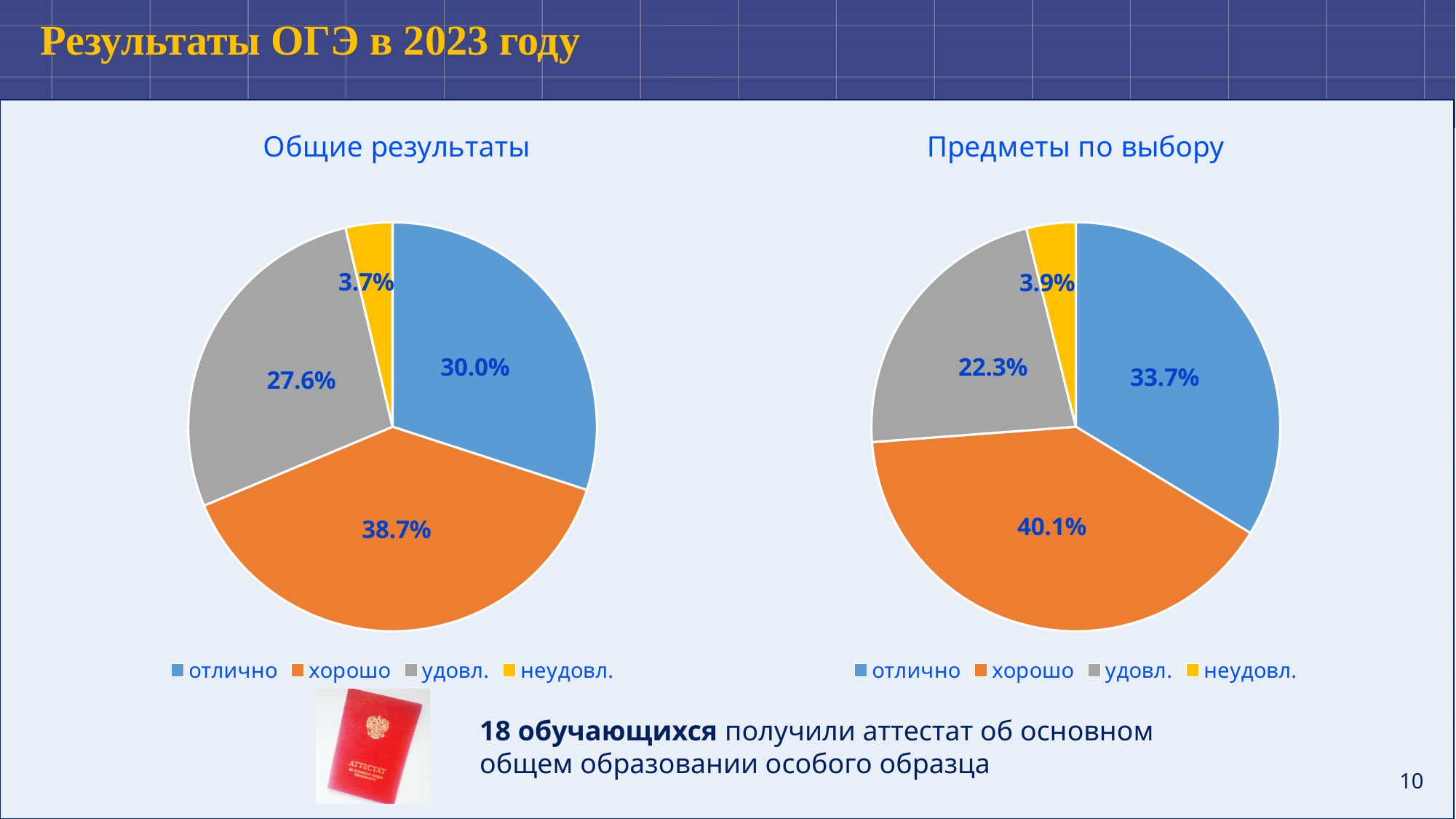
How many entries does the legend of the 'Предметы по выбору' chart list? 4 In the 'Общие результаты' chart, which category has the largest slice? хорошо How many slices does the 'Общие результаты' chart have? 4 In the 'Предметы по выбору' chart, which category has the smallest slice? неудовл. What type of chart is 'Общие результаты'? pie chart In the 'Общие результаты' chart, what is the difference between the 'хорошо' and 'отлично' shares? 8.7% In the 'Предметы по выбору' chart, what share is labelled for 'отлично'? 33.7% In the 'Предметы по выбору' chart, which is larger: 'отлично' or 'удовл.'? отлично In the 'Общие результаты' chart, what share is labelled for 'неудовл.'? 3.7% In the 'Предметы по выбору' chart, what share is labelled for 'удовл.'? 22.3% In the 'Общие результаты' chart, what share is labelled for 'хорошо'? 38.7% In the 'Предметы по выбору' chart, what colour is the 'хорошо' slice? orange